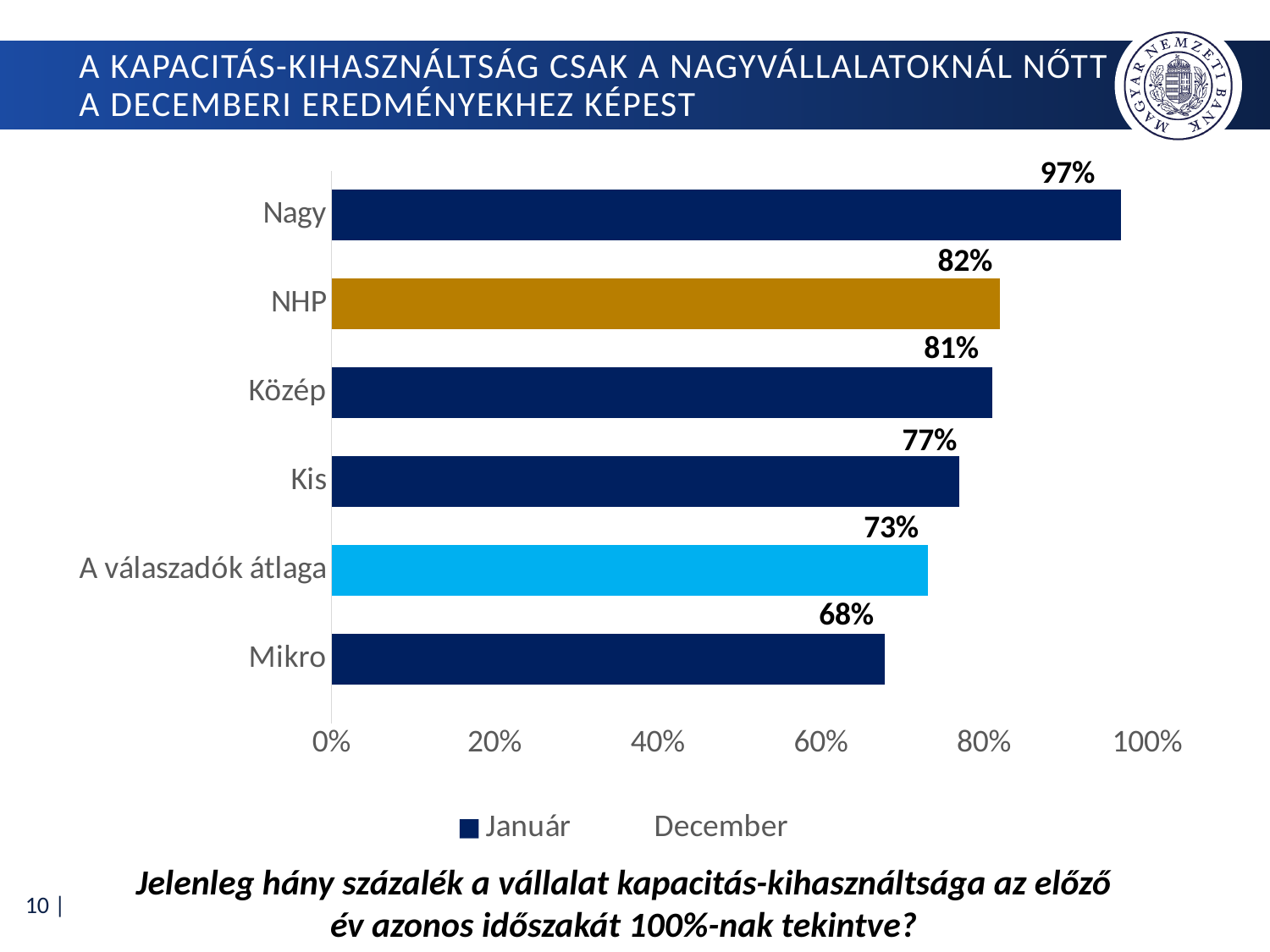
Which category has the highest value? Nagy What is the difference between the values for Kis and A válaszadók átlaga? 4% What is the difference between the values for Nagy and Mikro? 29% What is the value for Mikro? 68% Which is larger, the value for Kis or the value for Közép? Közép How many series does the legend list? 2 Which category has the lowest value? Mikro What is the value for Nagy? 97% What is the value for A válaszadók átlaga? 73% How many categories are shown on the chart? 6 What kind of chart is shown on the slide? Bar chart What is the value for NHP? 82%